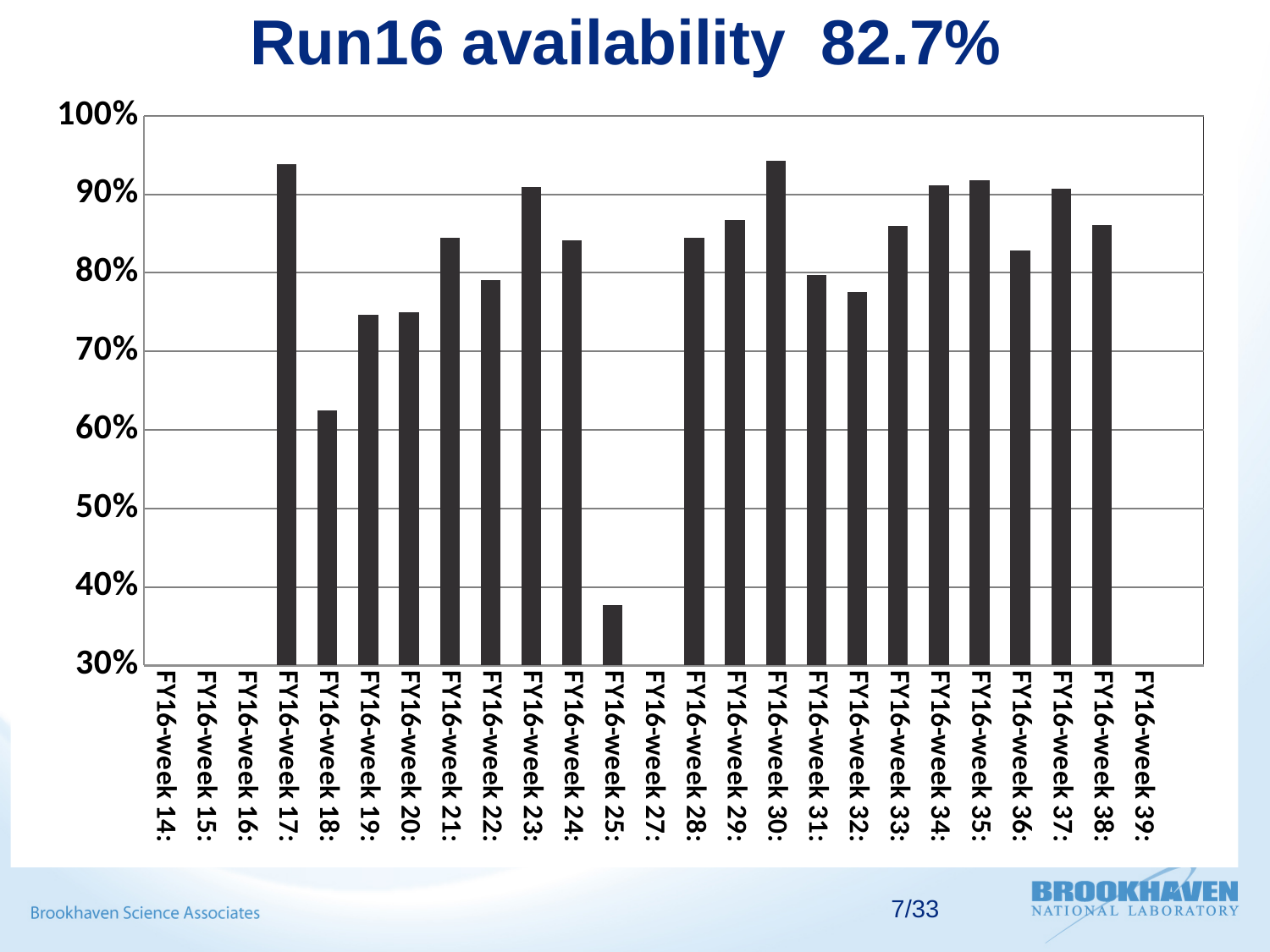
Which is larger, the value for FY16-week 31 or FY16-week 33? FY16-week 33 What kind of chart is shown on the slide? bar chart How many week categories are labelled on the x axis? 25 Is the value for FY16-week 18 greater or less than 60%? greater Which is larger, the value for FY16-week 21 or FY16-week 22? FY16-week 21 Is the value for FY16-week 25 greater or less than 40%? less Which week has the shortest visible bar? FY16-week 25 Is the value for FY16-week 19 greater or less than 70%? greater What is the title of the chart? Run16 availability 82.7% Which is larger, the value for FY16-week 18 or FY16-week 19? FY16-week 19